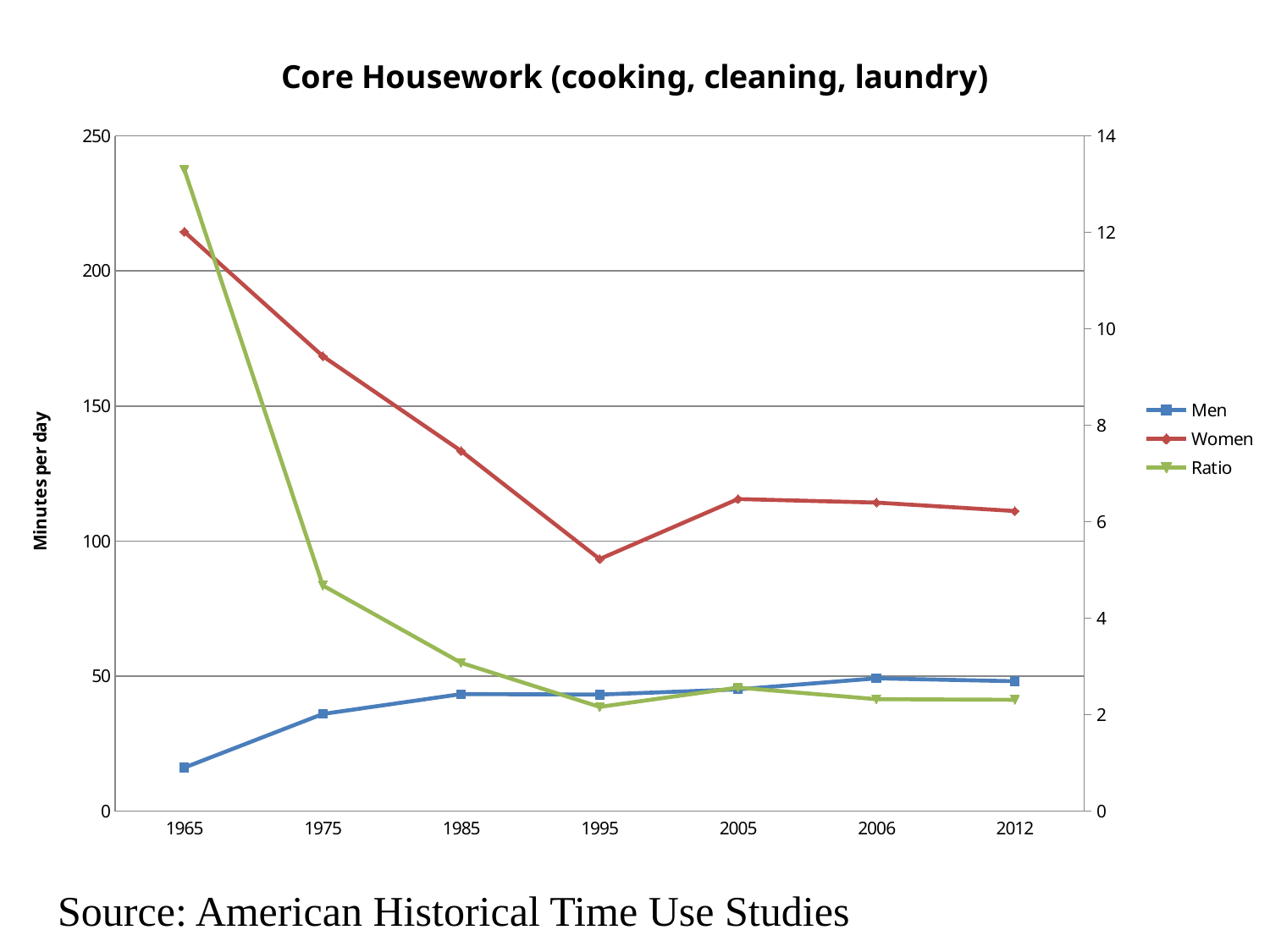
Does the Men series generally rise or fall from 1965 to 2012? Rise How many years are plotted along the x axis? 7 What is the title of the chart? Core Housework (cooking, cleaning, laundry) How many series does the legend list? 3 What kind of chart is shown on the slide? Line chart Which is larger in 1965, the value for Men or the value for Women? Women In which year is the value for Women highest? 1965 In which year is the value for Women lowest? 1995 In which year is the value for Men lowest? 1965 Is the value for Women in 1995 greater or less than 100? less Is the value for Women in 1965 greater or less than 200? greater Is the value for Men in 1965 greater or less than 50? less